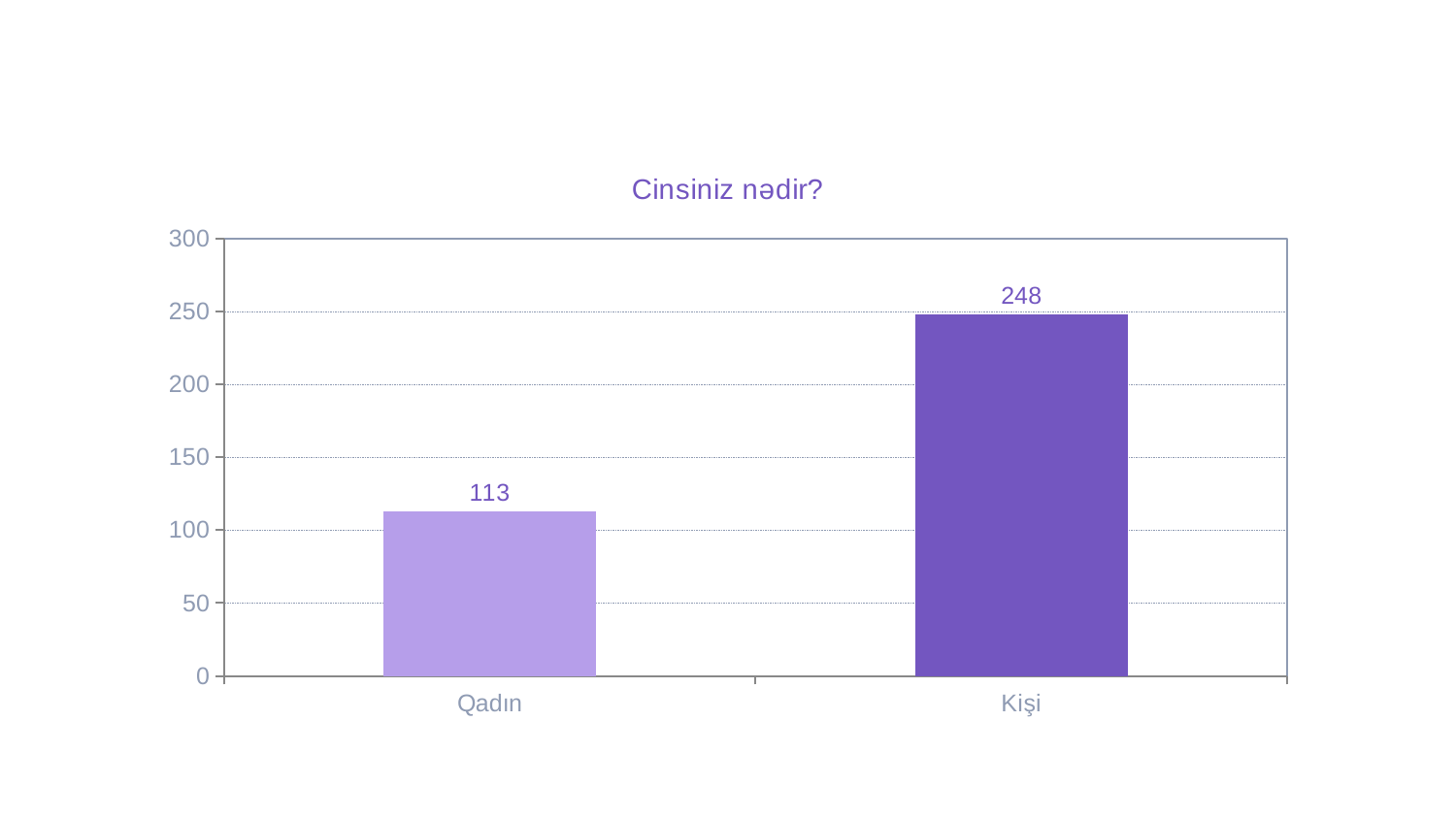
What is the highest value shown on the y axis? 300 Is the value for Qadın greater or less than 150? less What is the difference between the values for Kişi and Qadın? 135 Which is larger, the value for Qadın or the value for Kişi? Kişi What is the value for Qadın? 113 Which category has the lowest value? Qadın Is the value for Kişi greater or less than 200? greater How many categories are shown on the x axis? 2 What kind of chart is shown on the slide? bar chart What is the title of the chart? Cinsiniz nədir? Which category has the highest value? Kişi What is the value for Kişi? 248